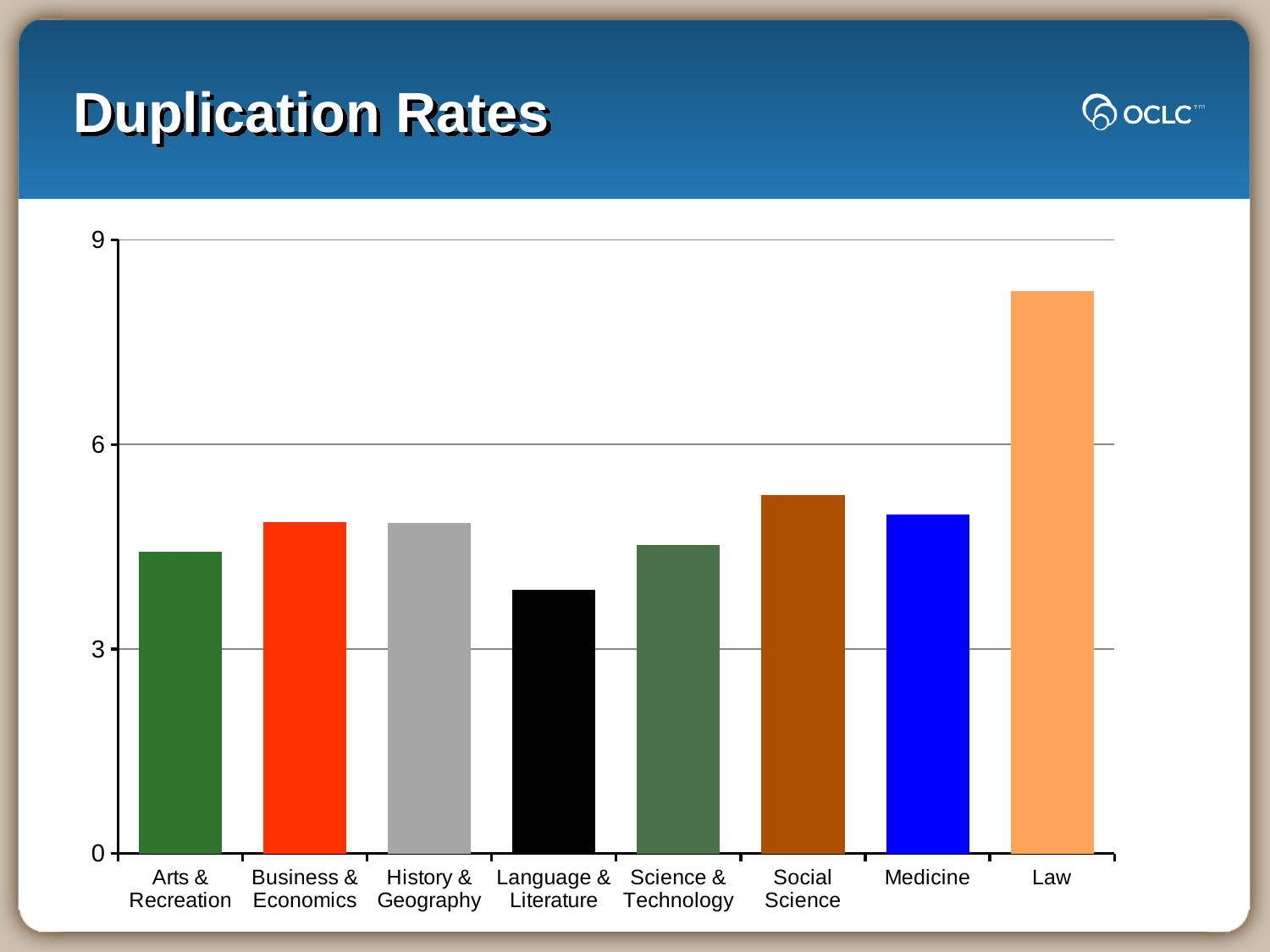
What kind of chart is shown on the slide? bar chart Is the value for Arts & Recreation greater or less than 3? greater How many categories are plotted on the chart? 8 What is the title of the slide? Duplication Rates Which category has the highest duplication rate? Law Which category has the lowest duplication rate? Language & Literature Is the value for Social Science greater or less than 6? less Is the value for Language & Literature greater or less than 3? greater Which is larger, the value for Social Science or the value for Language & Literature? Social Science What is the highest value shown on the vertical axis? 9 Which is larger, the value for Law or the value for Medicine? Law